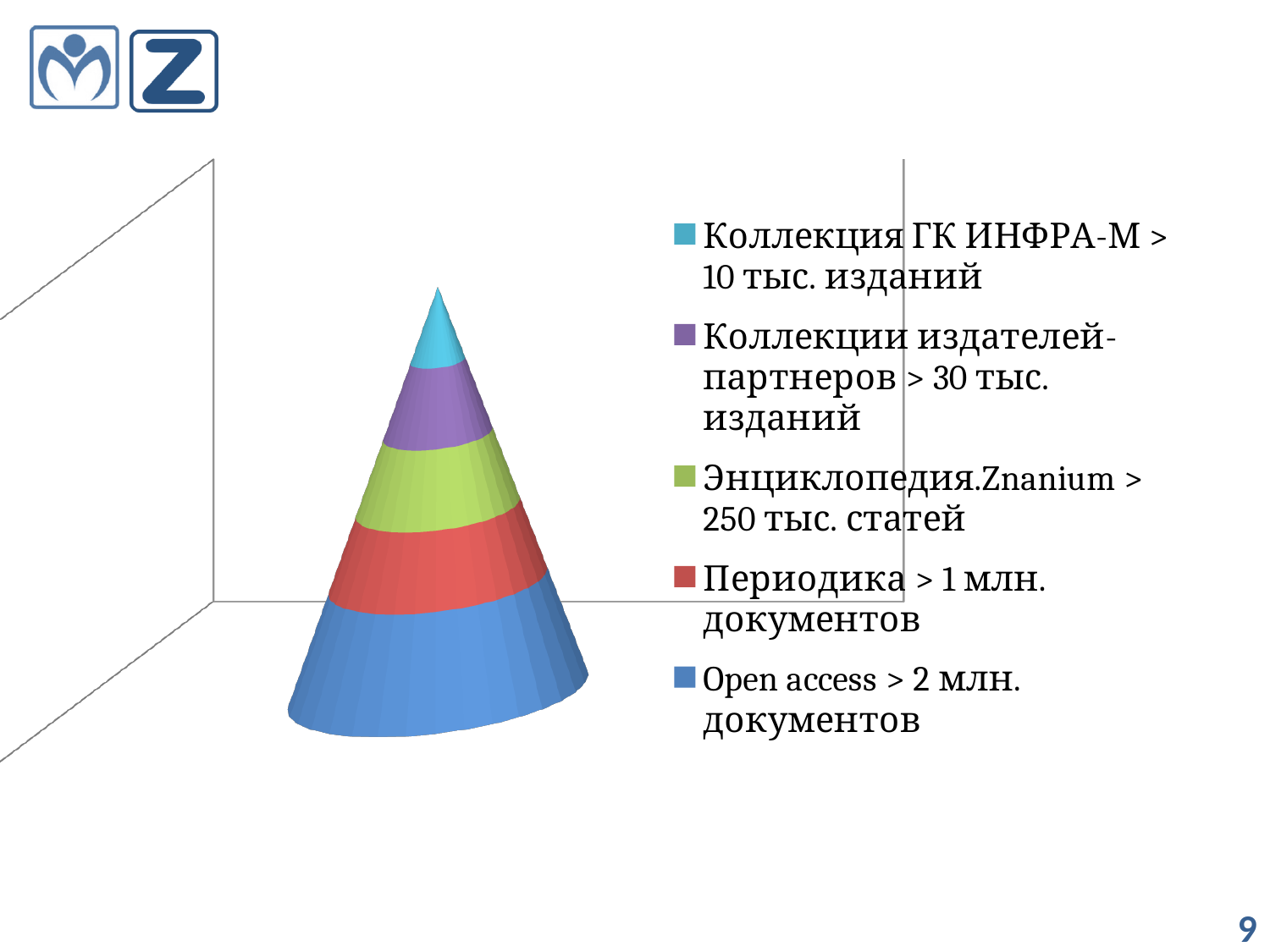
Which series occupies the smallest segment of the cone? Коллекция ГК ИНФРА-М > 10 тыс. изданий How many segments make up the cone? 5 What kind of chart is shown on the slide? stacked cone chart Is the segment for Энциклопедия.Znanium larger or smaller than the segment for Open access? smaller Which colour represents Open access in the chart? blue How many series does the legend of the cone chart list? 5 Which series occupies the largest segment of the cone? Open access > 2 млн. документов Which legend entry is shown in green? Энциклопедия.Znanium > 250 тыс. статей